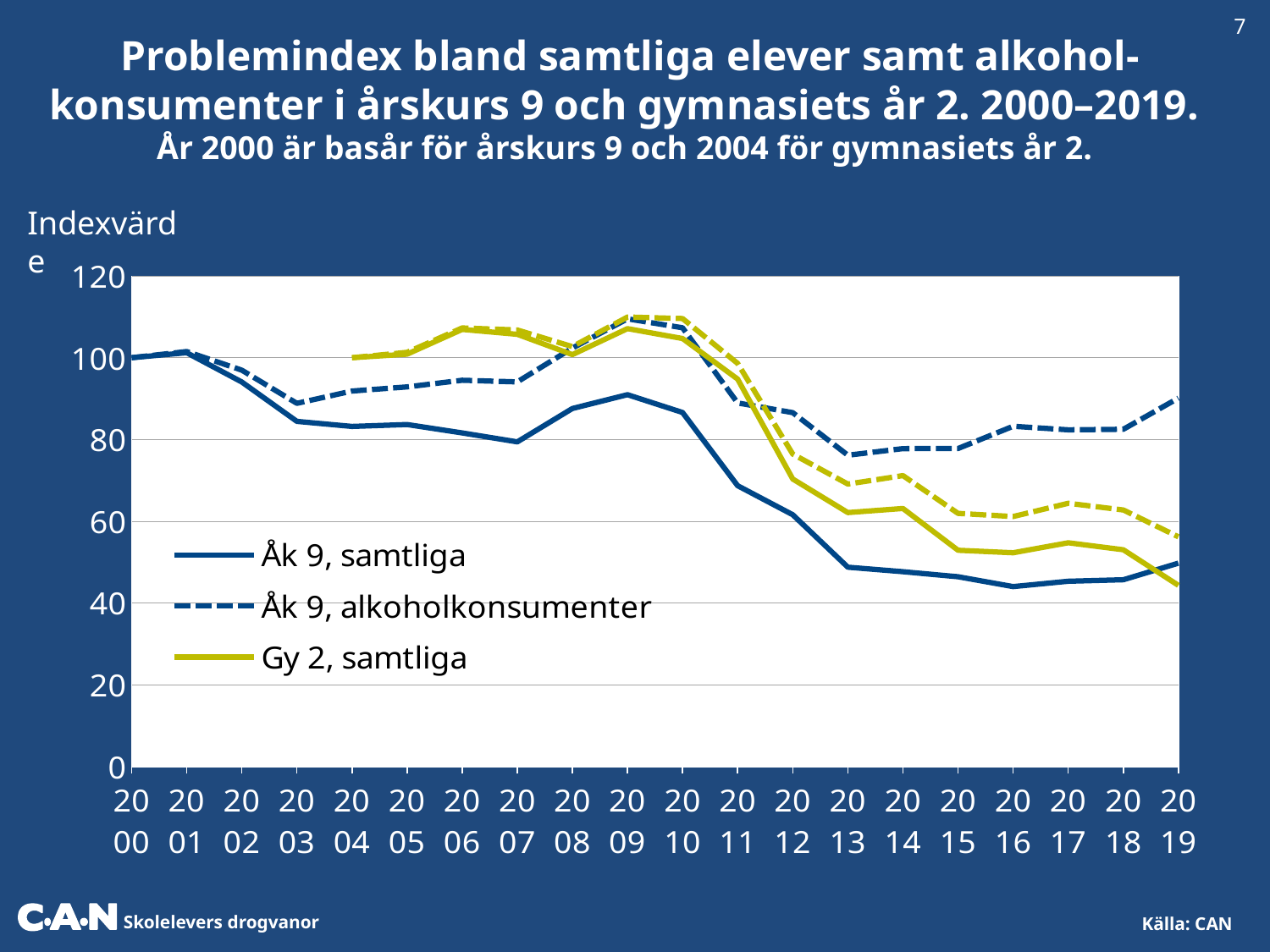
In 2016, which is higher: Åk 9, alkoholkonsumenter or Åk 9, samtliga? Åk 9, alkoholkonsumenter Which series is drawn with a dashed line? Åk 9, alkoholkonsumenter How many series does the legend list? 3 How many years are shown on the x axis? 20 What is the index value for Åk 9, samtliga in 2000? 100 Is the value for Gy 2, samtliga in 2009 greater or less than 100? greater What kind of chart is shown on the slide? line chart Which series has the highest value in 2019? Åk 9, alkoholkonsumenter Does the Åk 9, samtliga line rise or fall between 2010 and 2013? fall Is the value for Åk 9, samtliga in 2013 greater or less than 60? less What is the index value for Gy 2, samtliga in 2004? 100 Is the value for Åk 9, alkoholkonsumenter in 2019 greater or less than 80? greater